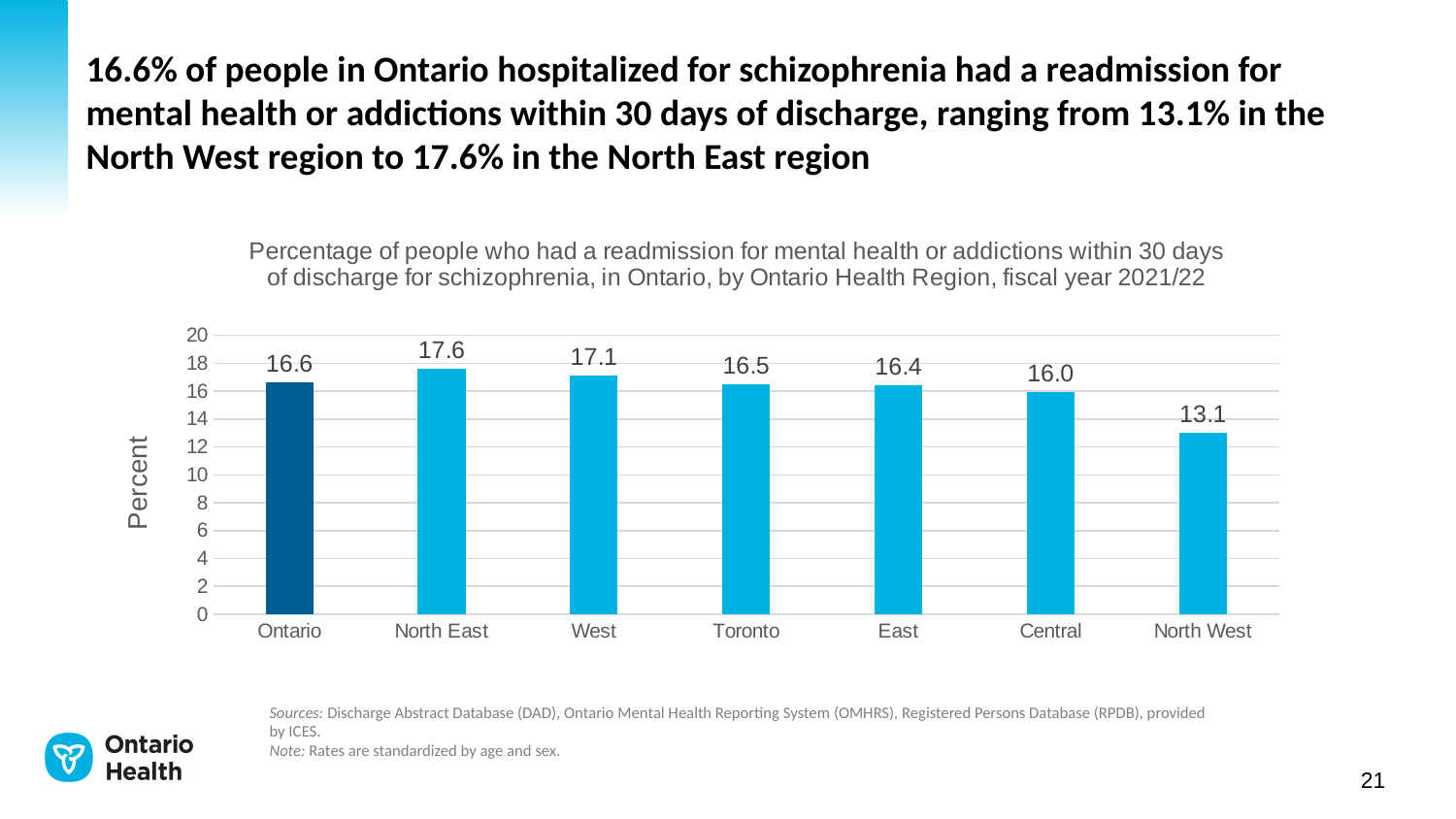
Which region has the lowest readmission percentage? North West What is the value for the North East region? 17.6 What kind of chart is shown on the slide? Bar chart How many bars are shown in the chart? 7 Which is larger, the value for West or the value for Central? West What is the label on the vertical axis? Percent What is the value for Toronto? 16.5 What is the value for Ontario? 16.6 What is the difference between the West and Central values? 1.1 What is the value for the North West region? 13.1 What is the difference between the North East and North West values? 4.5 Which region has the highest readmission percentage? North East